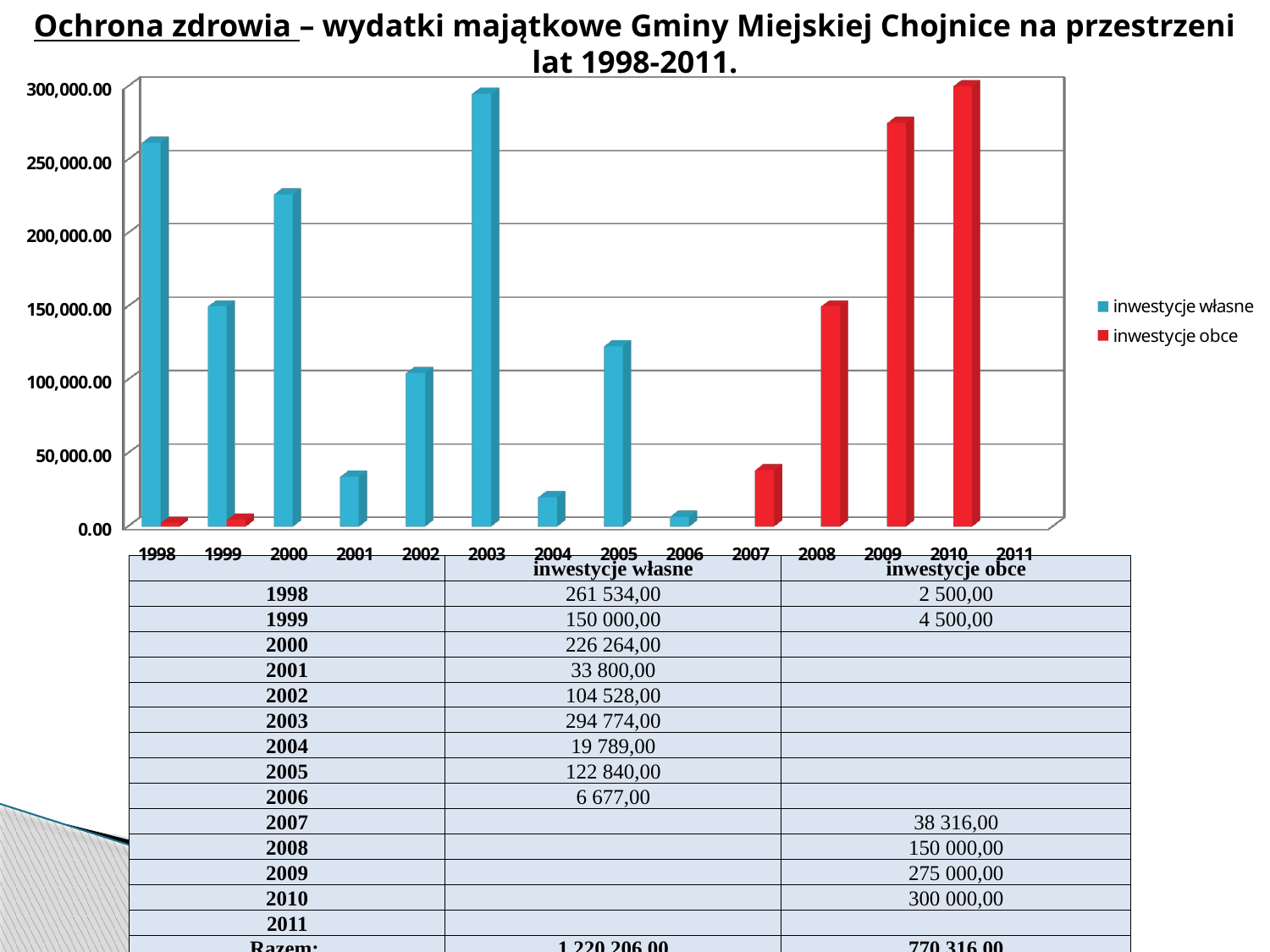
Is the value of inwestycje własne for 2002 greater or less than 100,000.00? greater What is the difference between inwestycje obce in 2010 and in 2009? 25 000,00 In which year is inwestycje obce highest? 2010 What is the value of inwestycje obce for 2009? 275 000,00 What is the value of inwestycje własne for 2003? 294 774,00 Among the years with a non-zero value, in which year is inwestycje własne lowest? 2006 How many series does the chart legend list? 2 In which year is inwestycje własne highest? 2003 Which is larger: inwestycje własne in 2000 or inwestycje obce in 2009? inwestycje obce in 2009 Do the inwestycje obce values rise or fall from 2007 to 2010? rise How many years are shown along the x axis of the chart? 14 What type of chart is shown on the slide? bar chart